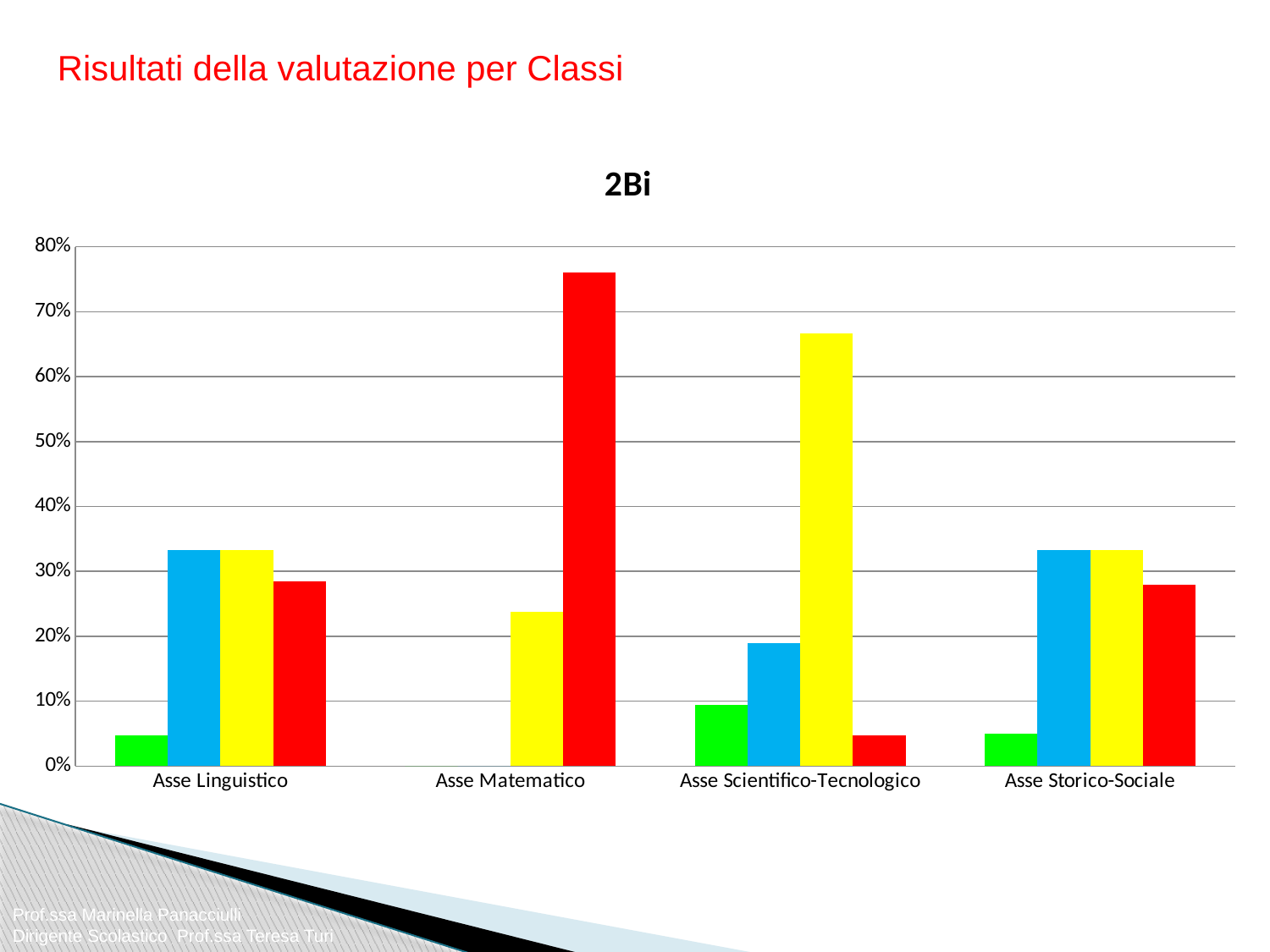
What kind of chart is shown on the slide? bar chart Is the value of the red bar for Asse Scientifico-Tecnologico greater or less than 10%? less Is the value of the yellow bar for Asse Matematico greater or less than 30%? less How many bars are visible for the Asse Matematico category? 2 Which category contains the tallest bar in the chart? Asse Matematico How many categories are shown on the x axis of the chart? 4 Is the value of the yellow bar for Asse Scientifico-Tecnologico greater or less than 60%? greater What is the highest value shown on the y axis of the chart? 80% Which is larger: the red bar for Asse Matematico or the yellow bar for Asse Scientifico-Tecnologico? the red bar for Asse Matematico What is the title of the chart? 2Bi